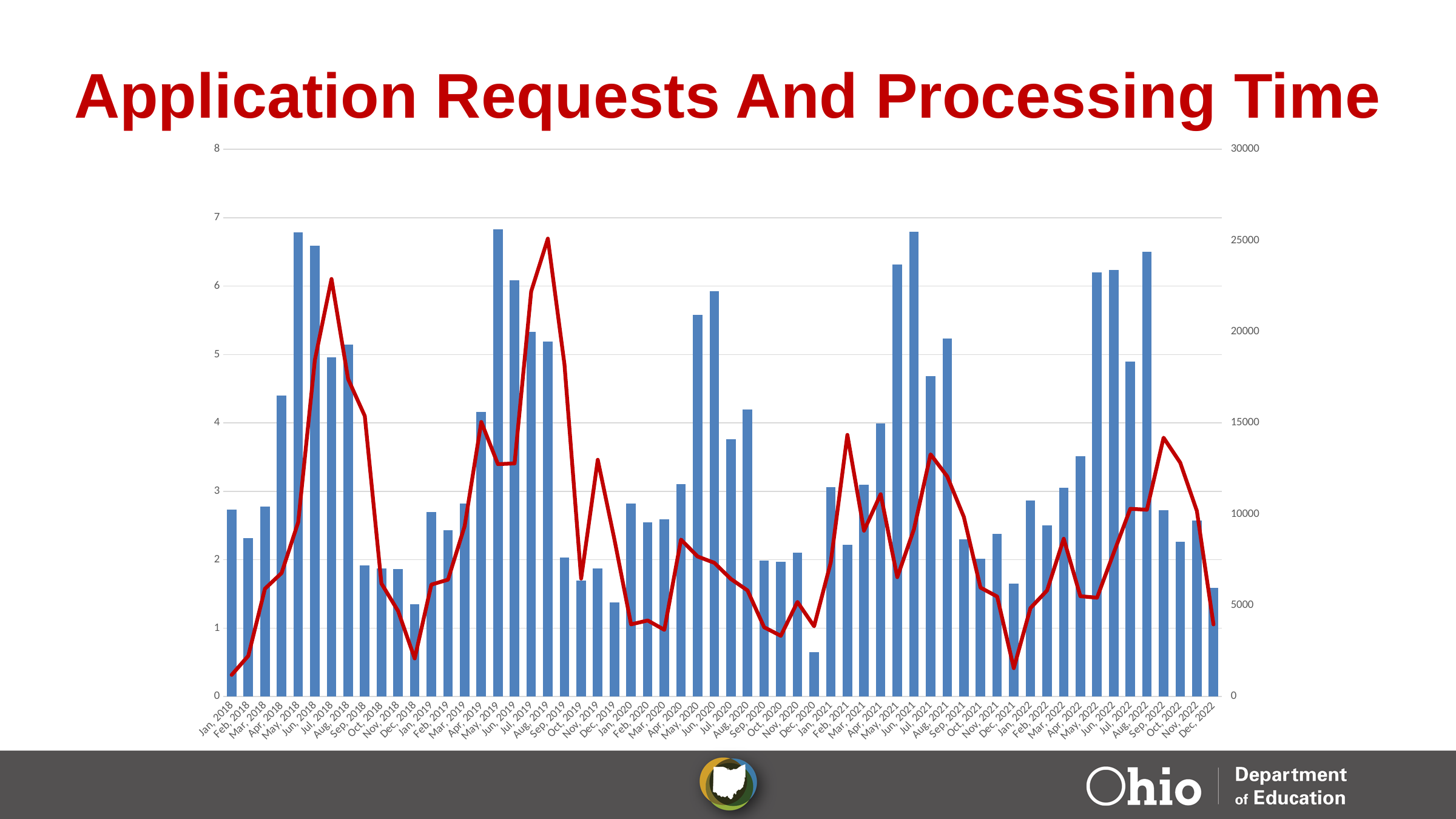
What is the first month shown on the x axis? Jan, 2018 Do the bars rise or fall from Jan, 2018 to Jun, 2018? rise What is the highest value shown on the right-hand vertical axis? 30000 How many monthly categories are plotted along the x axis? 60 Which month has the shortest bar in the chart? Dec, 2020 Measured against the left axis, is the bar for Dec, 2020 greater or less than 1? less Which bar is taller, Jul, 2021 or Dec, 2021? Jul, 2021 Does the red line rise or fall from Sep, 2019 to Oct, 2019? fall What is the title of the chart on the slide? Application Requests And Processing Time Which bar is taller, Jun, 2018 or Dec, 2018? Jun, 2018 What kind of chart is shown on the slide? A combined bar and line chart